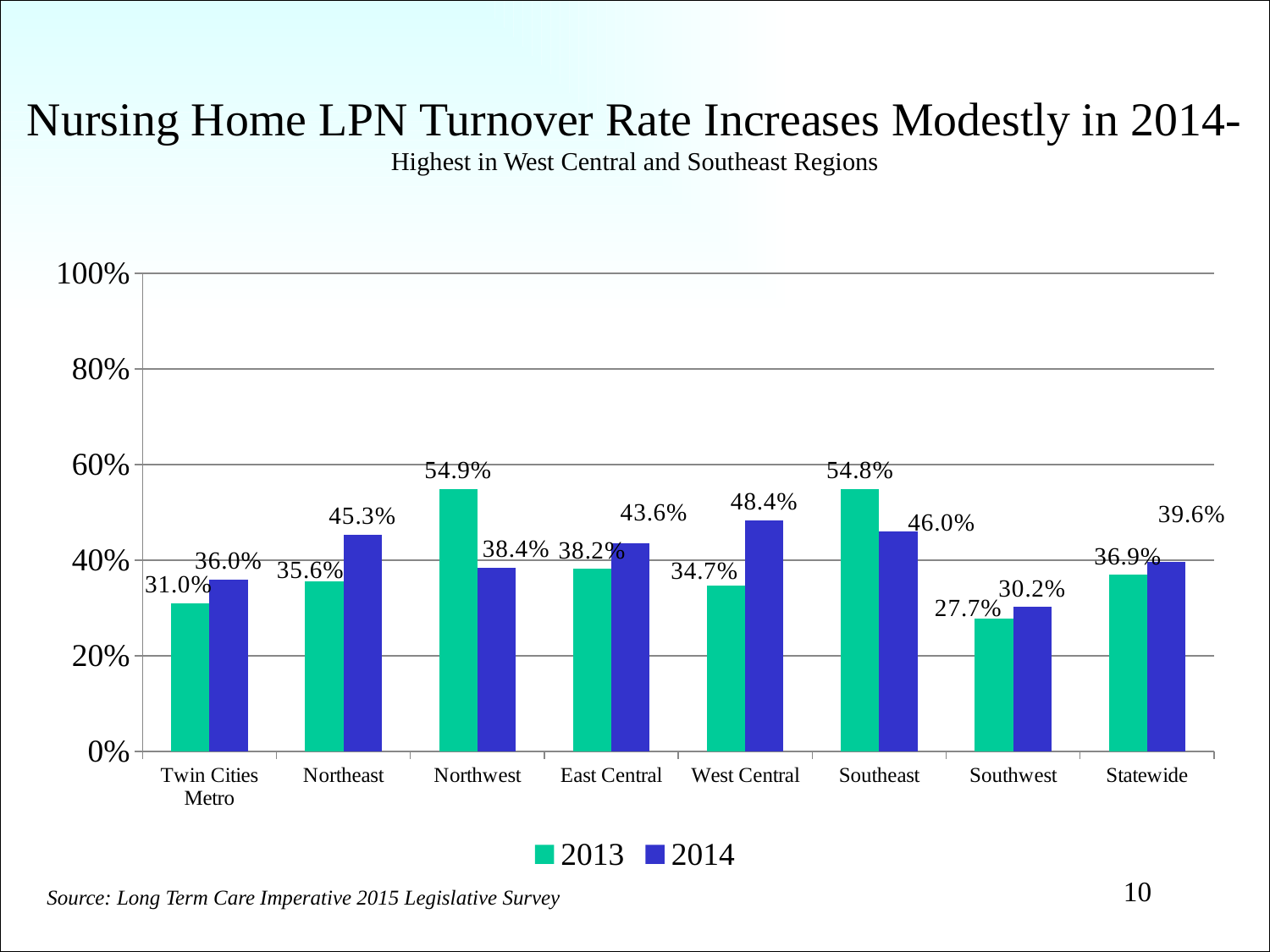
How many regions (categories) are shown on the x axis? 8 What is the 2014 LPN turnover rate for the West Central region? 48.4% For the Northwest region, which year has the higher turnover rate, 2013 or 2014? 2013 By how many percentage points did the Northeast turnover rate change from 2013 (35.6%) to 2014 (45.3%)? 9.7 percentage points What kind of chart is shown on the slide? Bar chart Which region has the highest 2014 LPN turnover rate? West Central What is the 2013 LPN turnover rate for the Northwest region? 54.9% What is the difference between the Northwest 2013 rate (54.9%) and its 2014 rate (38.4%)? 16.5 percentage points Is the 2013 turnover rate for the Southwest region greater or less than 40%? less What is the Statewide LPN turnover rate for 2014? 39.6% Which region has the lowest 2013 LPN turnover rate? Southwest How many series does the legend list? 2